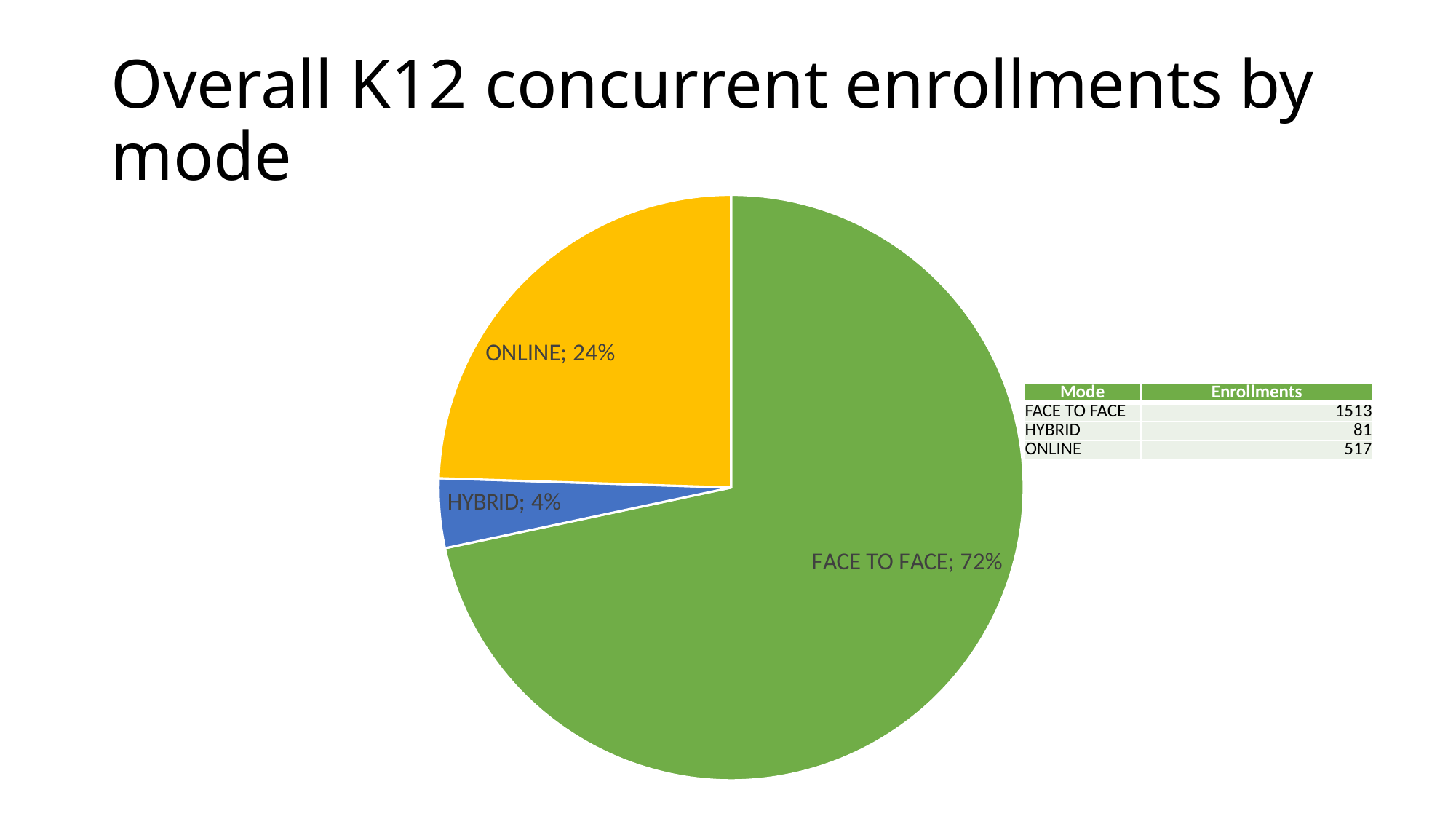
Which is larger, the ONLINE slice or the HYBRID slice? ONLINE What colour is the FACE TO FACE slice? green How many slices does the pie chart have? 3 Which mode has the smallest slice of the pie? HYBRID What kind of chart is shown on the slide? pie chart What share of the pie does ONLINE represent? 24% What is the difference in percentage points between the ONLINE and HYBRID slices? 20 What is the difference in percentage points between the FACE TO FACE and ONLINE slices? 48 Which mode has the largest slice of the pie? FACE TO FACE What share of the pie does FACE TO FACE represent? 72% What share of the pie does HYBRID represent? 4% What is the title of the slide containing the pie chart? Overall K12 concurrent enrollments by mode